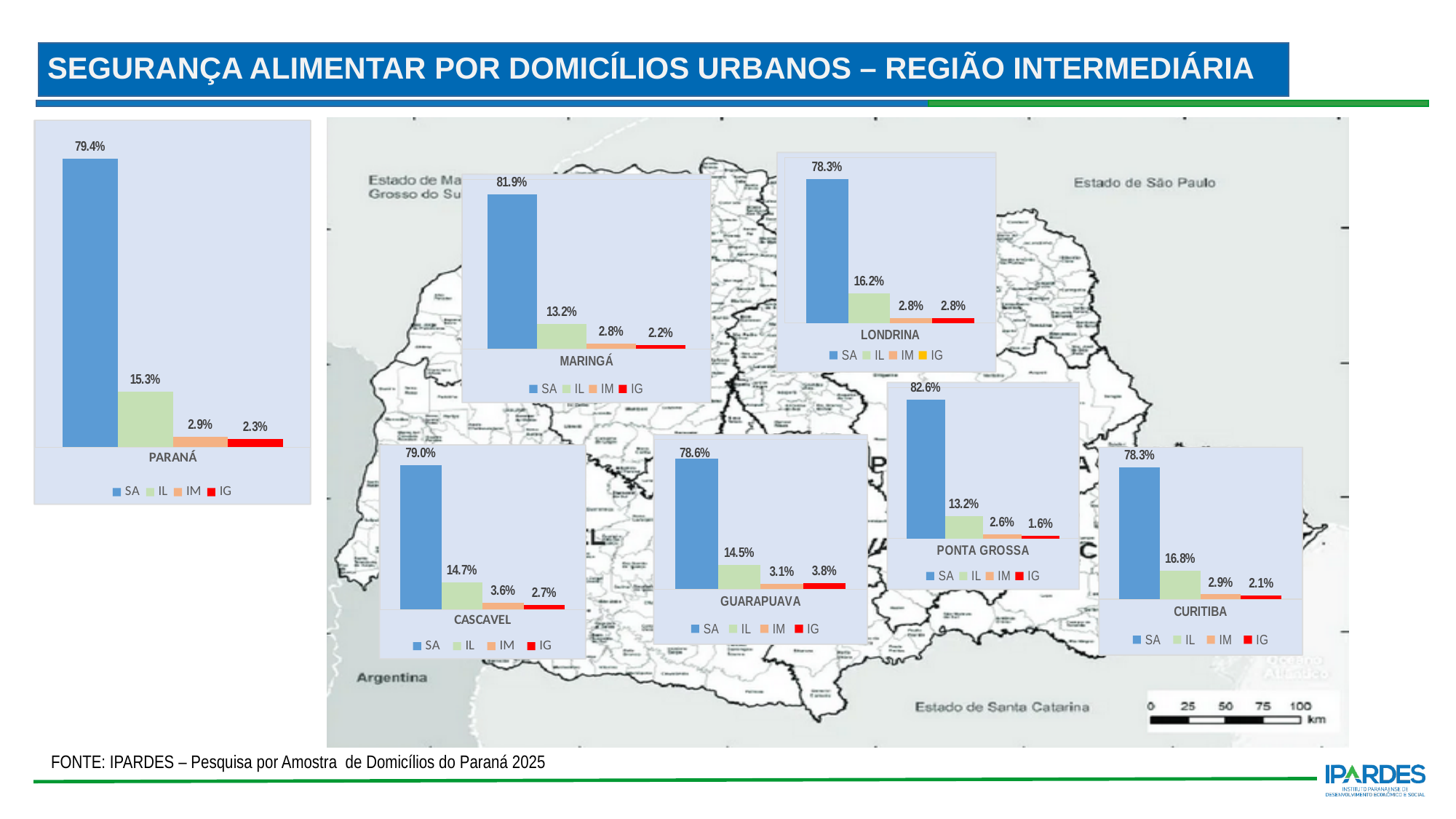
How many series does the legend of the PARANÁ chart list? 4 What kind of chart is the LONDRINA chart? bar chart In the PONTA GROSSA chart, which category has the highest value? SA In the MARINGÁ chart, what is the value for IL? 13.2% In the CASCAVEL chart, what is the difference between the SA value and the IL value? 64.3% In the CURITIBA chart, which category has the lowest value? IG Which is larger: the SA value in the PONTA GROSSA chart or the SA value in the MARINGÁ chart? PONTA GROSSA How many categories are plotted in the CURITIBA chart? 4 In the PARANÁ chart, what is the value for SA? 79.4% In the LONDRINA chart, what is the value for IM? 2.8% In the GUARAPUAVA chart, what is the value for IG? 3.8% In the PONTA GROSSA chart, what is the value for IG? 1.6%